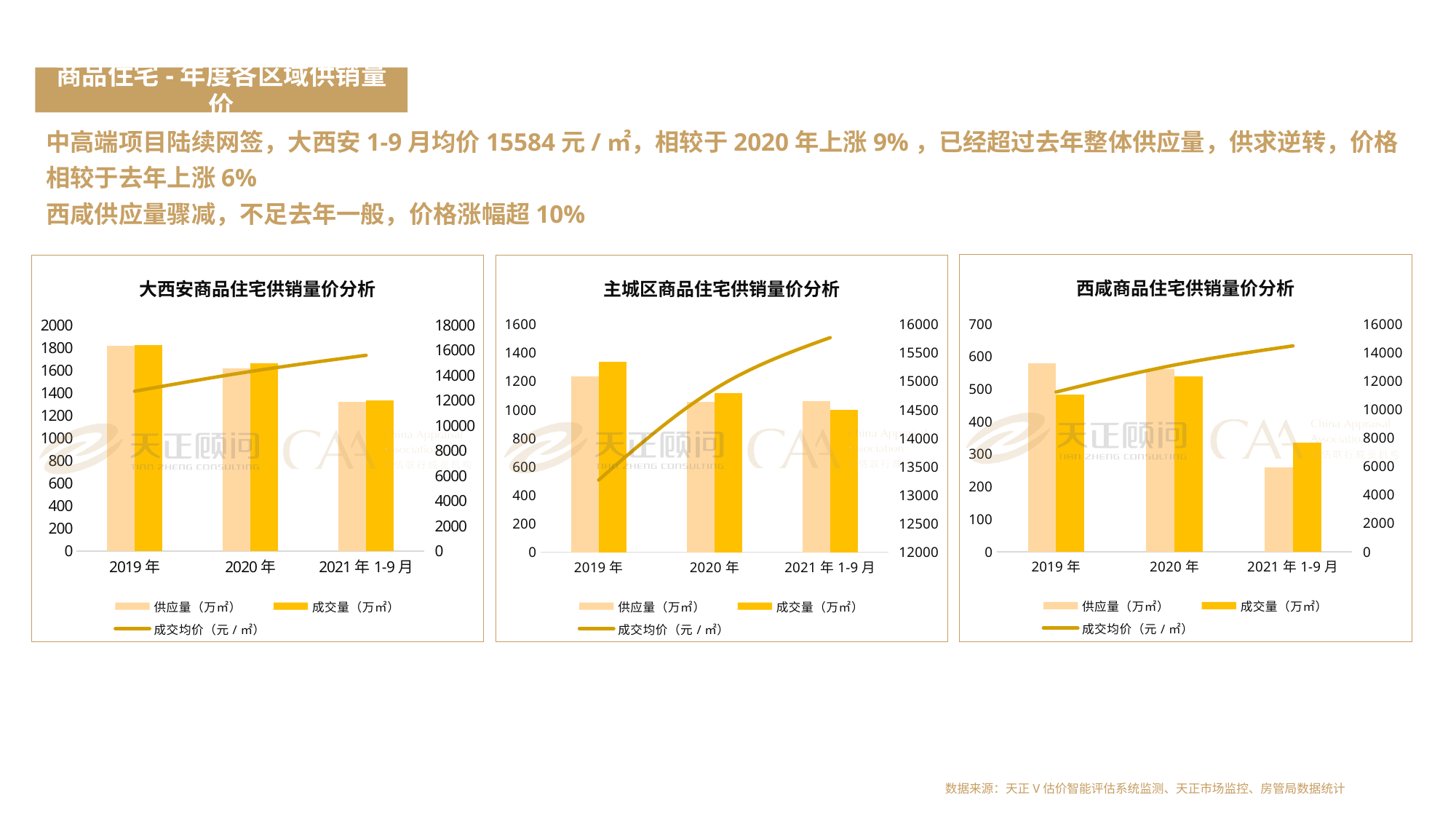
In the 大西安商品住宅供销量价分析 chart, is the 成交量 value for 2021年1-9月 greater or less than 1400? less In the 主城区商品住宅供销量价分析 chart, which category has the highest 成交量? 2019年 In the 大西安商品住宅供销量价分析 chart, how many series does the legend list? 3 In the 西咸商品住宅供销量价分析 chart, which is larger for 2021年1-9月, 供应量 or 成交量? 成交量 In the 西咸商品住宅供销量价分析 chart, which category has the lowest 供应量? 2021年1-9月 In the 大西安商品住宅供销量价分析 chart, is the 供应量 value for 2019年 greater or less than 1600? greater In the 主城区商品住宅供销量价分析 chart, which is larger for 2019年, 供应量 or 成交量? 成交量 In the 大西安商品住宅供销量价分析 chart, what kind of chart is it? bar chart with a line In the 主城区商品住宅供销量价分析 chart, is the 成交量 value for 2019年 greater or less than 1200? greater In the 大西安商品住宅供销量价分析 chart, how many categories are on the x axis? 3 In the 大西安商品住宅供销量价分析 chart, does the 成交均价 line rise or fall from 2019年 to 2021年1-9月? rise